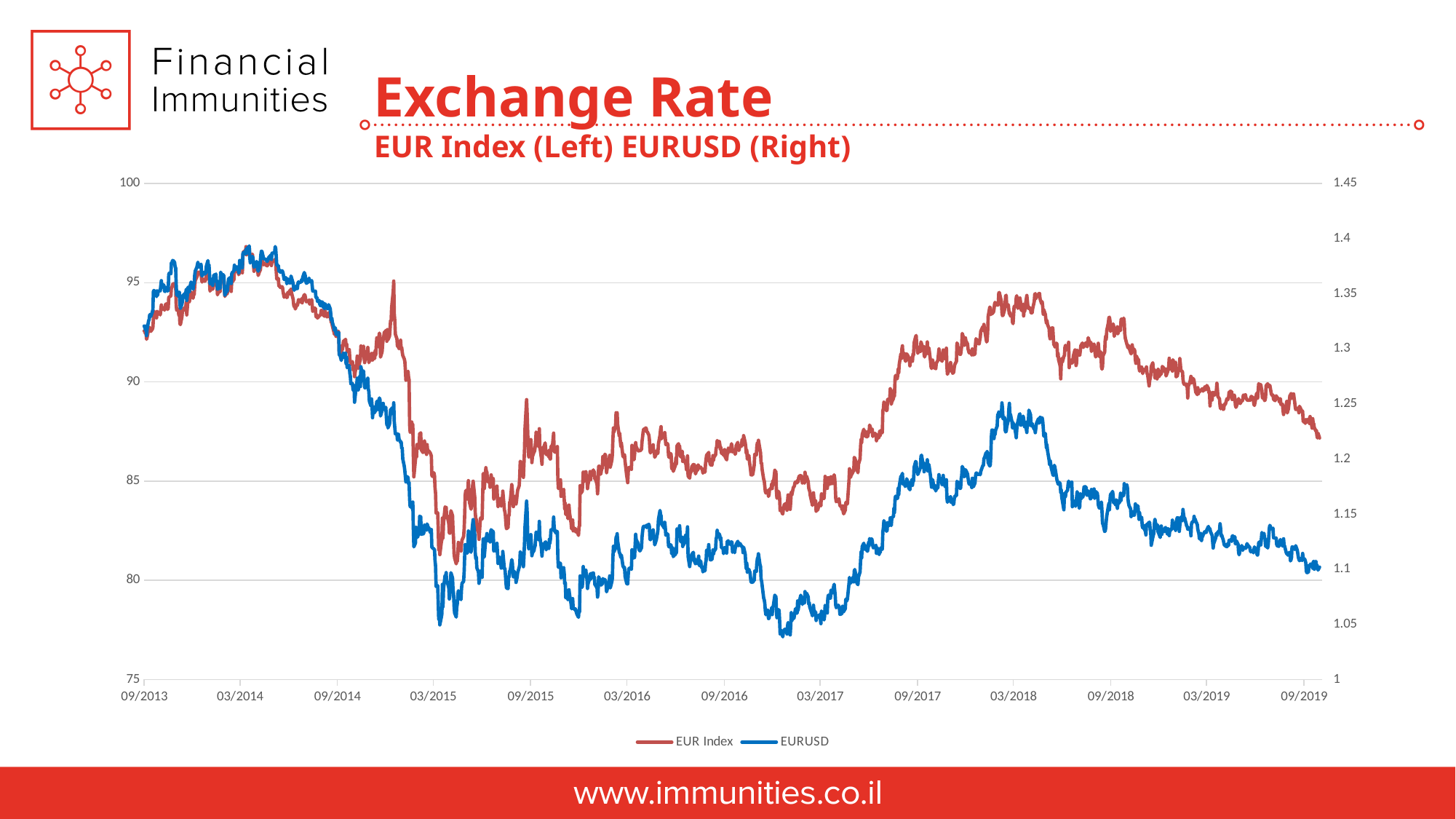
Is the value of EURUSD at 03/2018 greater or less than 1.2? greater Is the value of the EUR Index at 09/2019 greater or less than 90? less What is the title of the chart? Exchange Rate Is the value of EURUSD at 03/2017 greater or less than 1.15? less How many date labels are shown on the x axis? 13 Does EURUSD rise or fall overall from 09/2013 to 09/2019? fall Does the EUR Index rise or fall overall from 09/2013 to 09/2019? fall What kind of chart is shown on the slide? line chart How many series does the legend list? 2 Which colour is used for the EURUSD series? blue